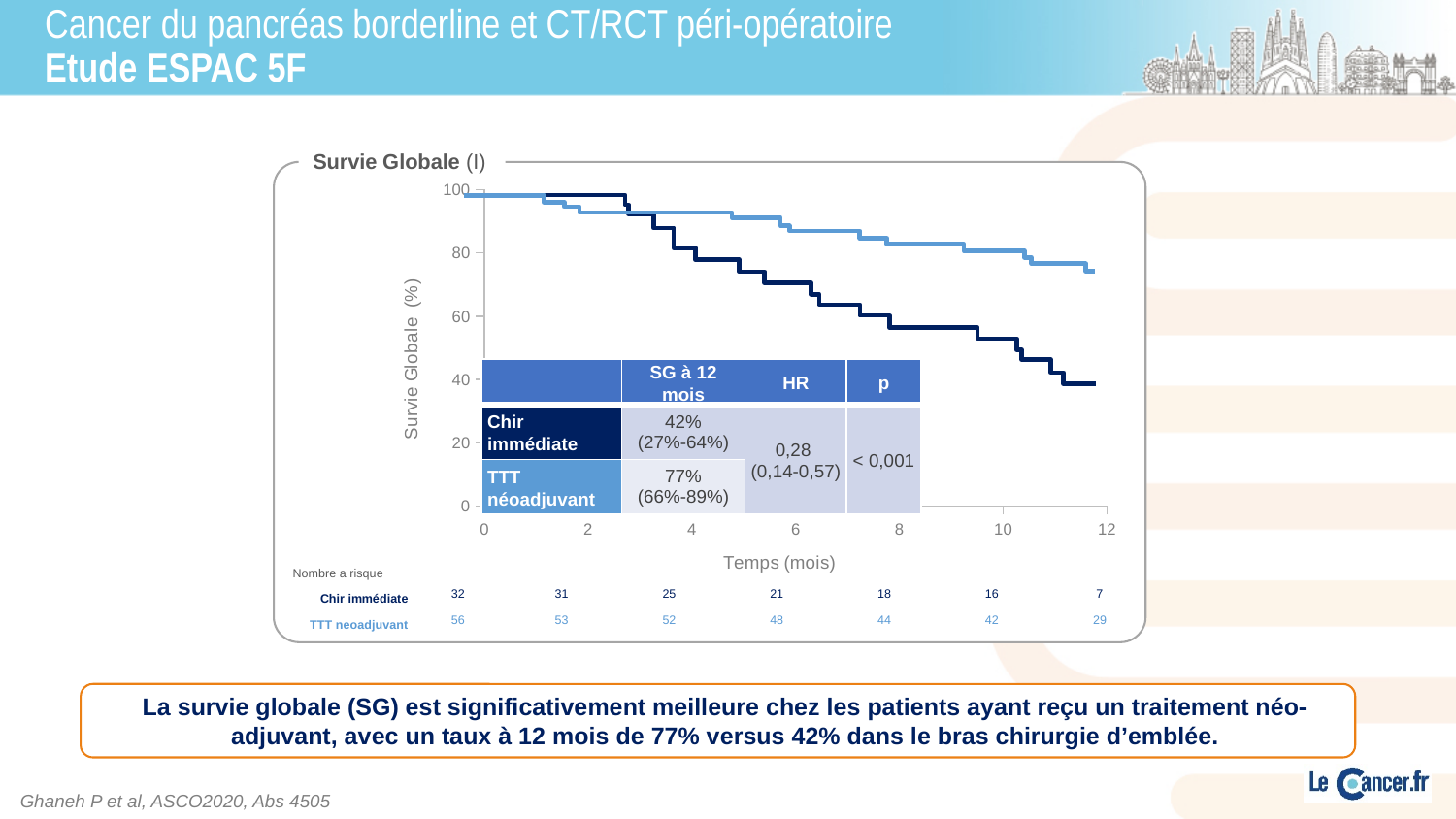
What is the hazard ratio (HR) reported in the table on the chart? 0,28 (0,14-0,57) What is the difference in 12-month overall survival between the TTT néoadjuvant and Chir immédiate groups? 35 percentage points What is the overall survival at 12 months (SG à 12 mois) for the Chir immédiate group? 42% How many patients are at risk in the Chir immédiate group at 12 months? 7 What is the overall survival at 12 months (SG à 12 mois) for the TTT néoadjuvant group? 77% How many groups (series) are plotted on the survival chart? 2 Which group has the higher overall survival at 12 months, Chir immédiate or TTT néoadjuvant? TTT néoadjuvant What kind of chart is shown on the slide? Line chart (survival curve) What is the label of the x axis of the survival chart? Temps (mois) Is the overall survival for the Chir immédiate group at 6 months greater or less than 80%? less Is the overall survival for the TTT néoadjuvant group at 6 months greater or less than 80%? greater What p value is reported in the table on the chart? < 0,001